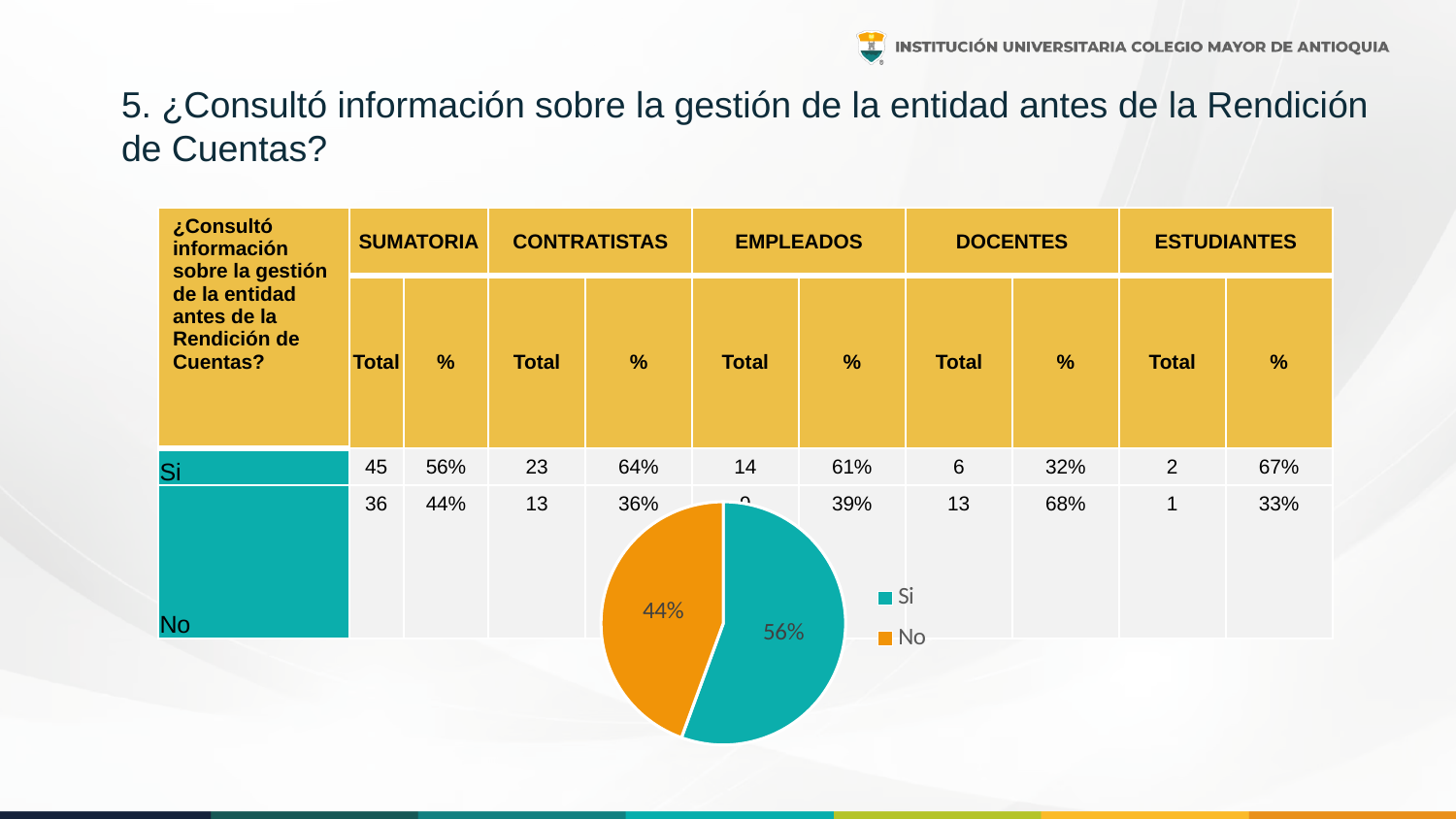
What share of the pie chart does the "No" slice represent? 44% Is the share of the "No" slice in the pie chart greater or less than 50%? less Which slice of the pie chart is the largest? Si How many slices does the pie chart have? 2 How many entries does the pie chart's legend list? 2 In the pie chart, which is larger, the "Si" slice or the "No" slice? Si What are the two entries listed in the pie chart's legend? Si and No What colour is the "Si" slice in the pie chart? teal By how many percentage points does the "Si" slice exceed the "No" slice in the pie chart? 12 Which slice of the pie chart is the smallest? No What kind of chart is shown on the slide? pie chart What share of the pie chart does the "Si" slice represent? 56%